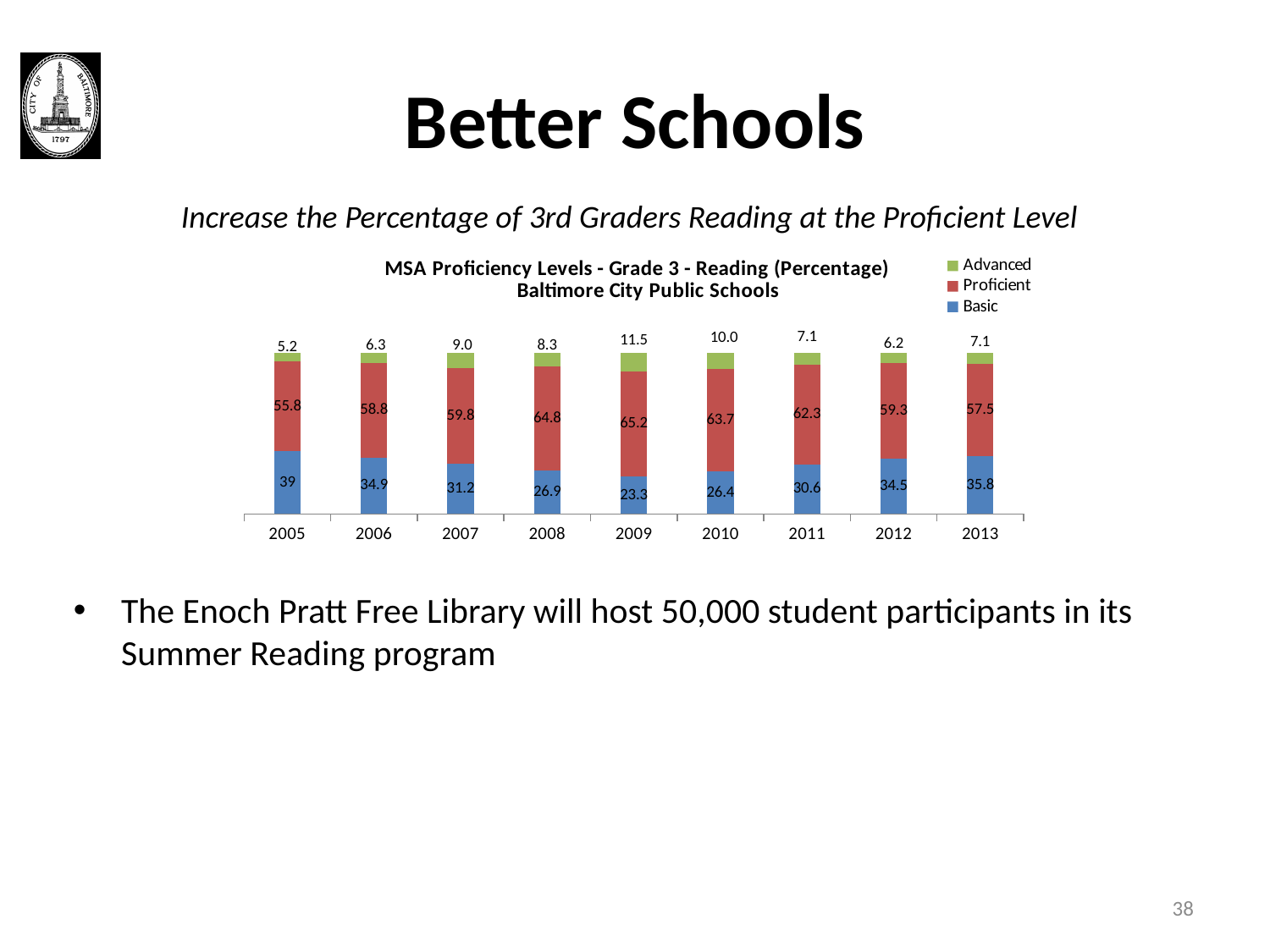
How many series does the legend list? 3 What is the Advanced value for 2010? 10.0 In which year is the Advanced value highest? 2009 How many years are shown on the x axis? 9 Which is larger, the Basic value in 2005 or in 2013? 2005 What is the Basic value for 2005? 39 In which year is the Advanced value lowest? 2005 Does the Basic value rise or fall from 2005 to 2009? Fall What is the difference between the Proficient value in 2009 and in 2005? 9.4 What is the Proficient value for 2009? 65.2 What kind of chart is shown? Stacked bar chart In which year is the Basic value lowest? 2009